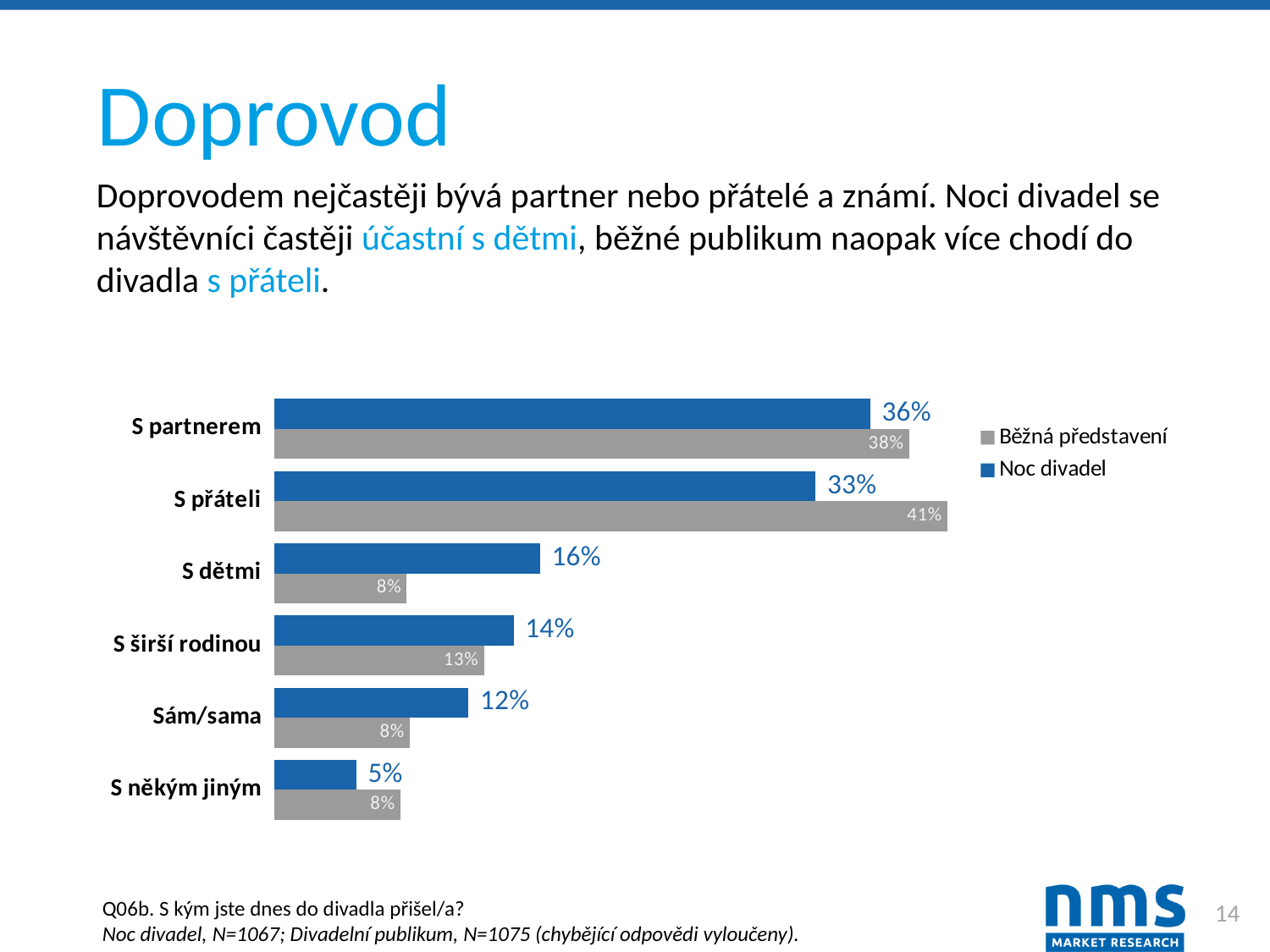
What is the value for 'S partnerem' in the 'Noc divadel' series? 36% What is the difference between 'Noc divadel' and 'Běžná představení' for 'S dětmi'? 8% What kind of chart is shown on the slide? Bar chart What is the difference between 'Běžná představení' and 'Noc divadel' for 'S přáteli'? 8% Which category has the highest value in the 'Běžná představení' series? S přáteli What is the value for 'S přáteli' in the 'Běžná představení' series? 41% How many series does the legend list? 2 What is the value for 'S dětmi' in the 'Noc divadel' series? 16% Which series has the larger value for 'Sám/sama'? Noc divadel Which series is shown in blue? Noc divadel How many categories are shown in the chart? 6 Which category has the lowest value in the 'Noc divadel' series? S někým jiným